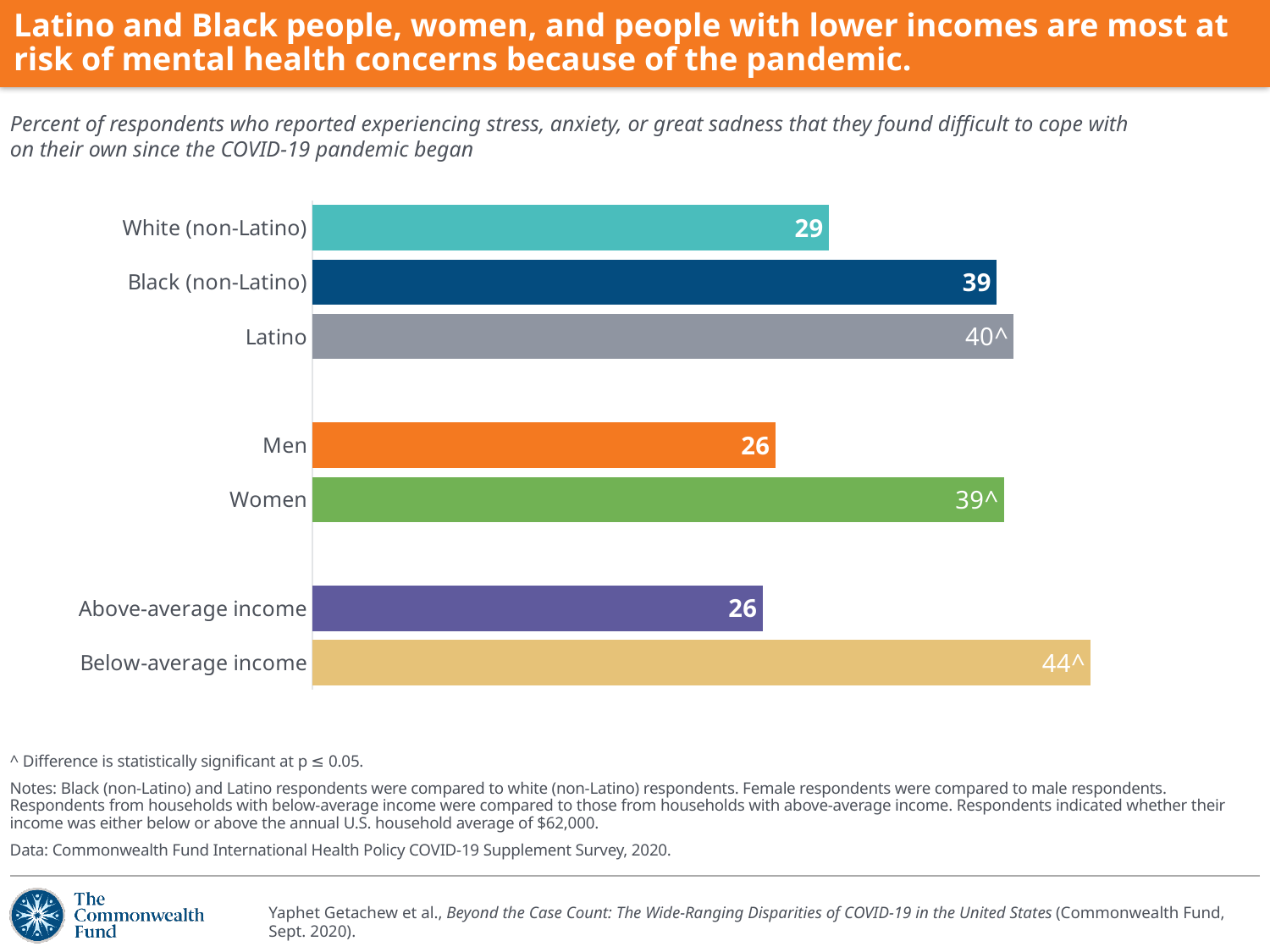
What is the difference between the values for Below-average income and Above-average income? 18 Which category has the lowest value? Men and Above-average income (both 26) What is the difference between the values for Women and Men? 13 What is the value shown for Below-average income? 44^ How many categories are plotted in the chart? 7 What is the value for White (non-Latino)? 29 Which category has the highest value? Below-average income What is the value shown for Latino respondents? 40^ What kind of chart is shown on the slide? Bar chart Which is larger, the value for Latino or the value for White (non-Latino)? Latino What is the value for Black (non-Latino)? 39 What is the value for Men? 26